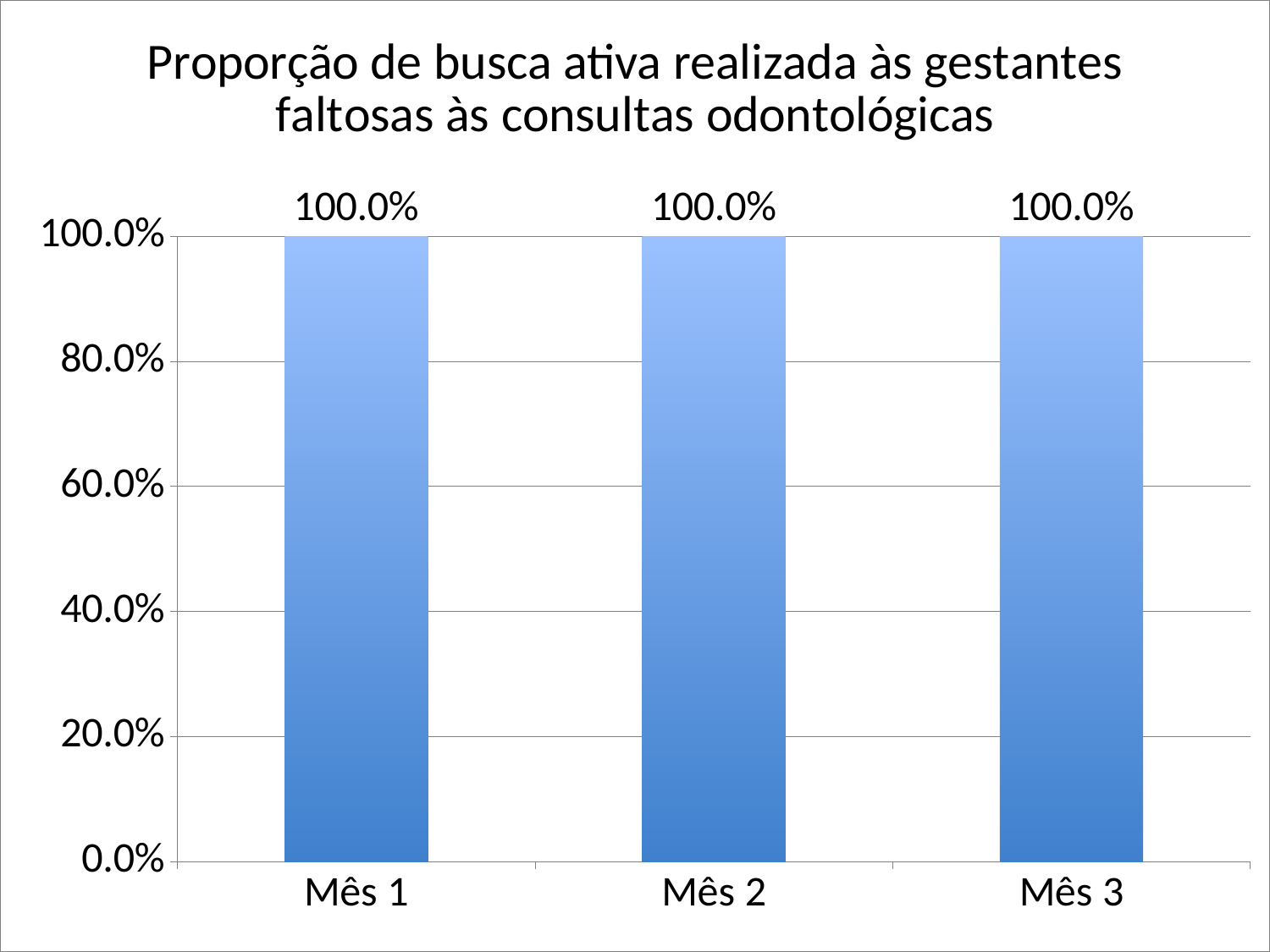
What is the value for Mês 2? 100.0% How many categories are shown on the x axis? 3 Do the values rise, fall or stay the same from Mês 1 to Mês 3? stay the same What is the value for Mês 3? 100.0% What is the value for Mês 1? 100.0% What is the highest value shown on the y axis? 100.0% What is the difference between the values for Mês 1 and Mês 3? 0.0% Is the value for Mês 2 greater or less than 80.0%? greater What kind of chart is this? bar chart What is the title of the chart? Proporção de busca ativa realizada às gestantes faltosas às consultas odontológicas